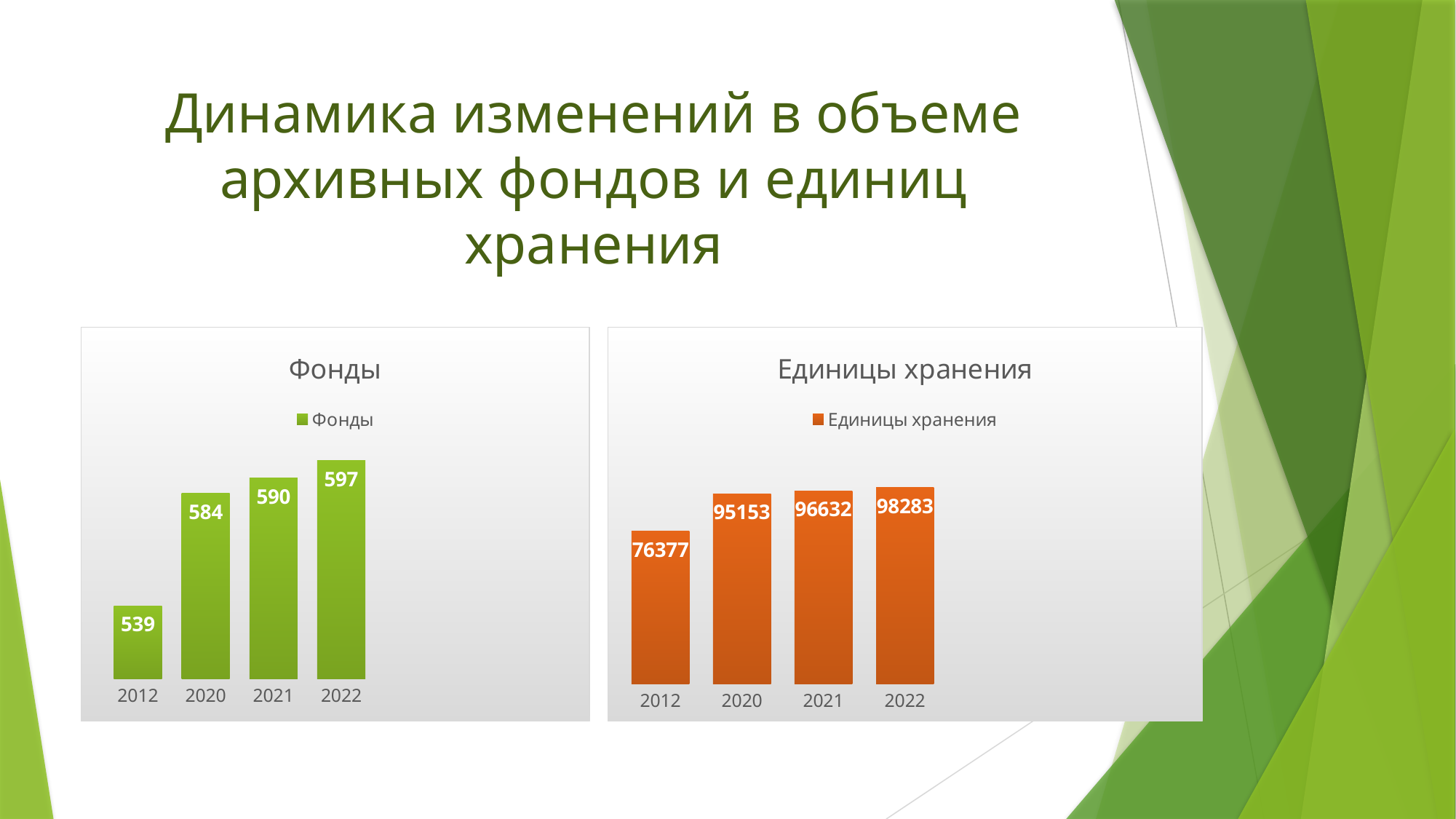
In the "Фонды" chart, what is the difference between the values for 2022 and 2012? 58 In the "Единицы хранения" chart, what is the value for 2012? 76377 How many years are shown in the "Единицы хранения" chart? 4 In the "Фонды" chart, what is the value for 2022? 597 In the "Фонды" chart, which year has the lowest value? 2012 In the "Единицы хранения" chart, what is the difference between the values for 2021 and 2020? 1479 In the "Единицы хранения" chart, which year has the highest value? 2022 In the "Единицы хранения" chart, what is the value for 2020? 95153 In the "Единицы хранения" chart, do the values rise or fall from 2012 to 2022? Rise In the "Фонды" chart, which is larger, the value for 2020 or the value for 2021? 2021 What kind of chart is the "Фонды" chart? Bar chart In the "Фонды" chart, what is the value for 2012? 539